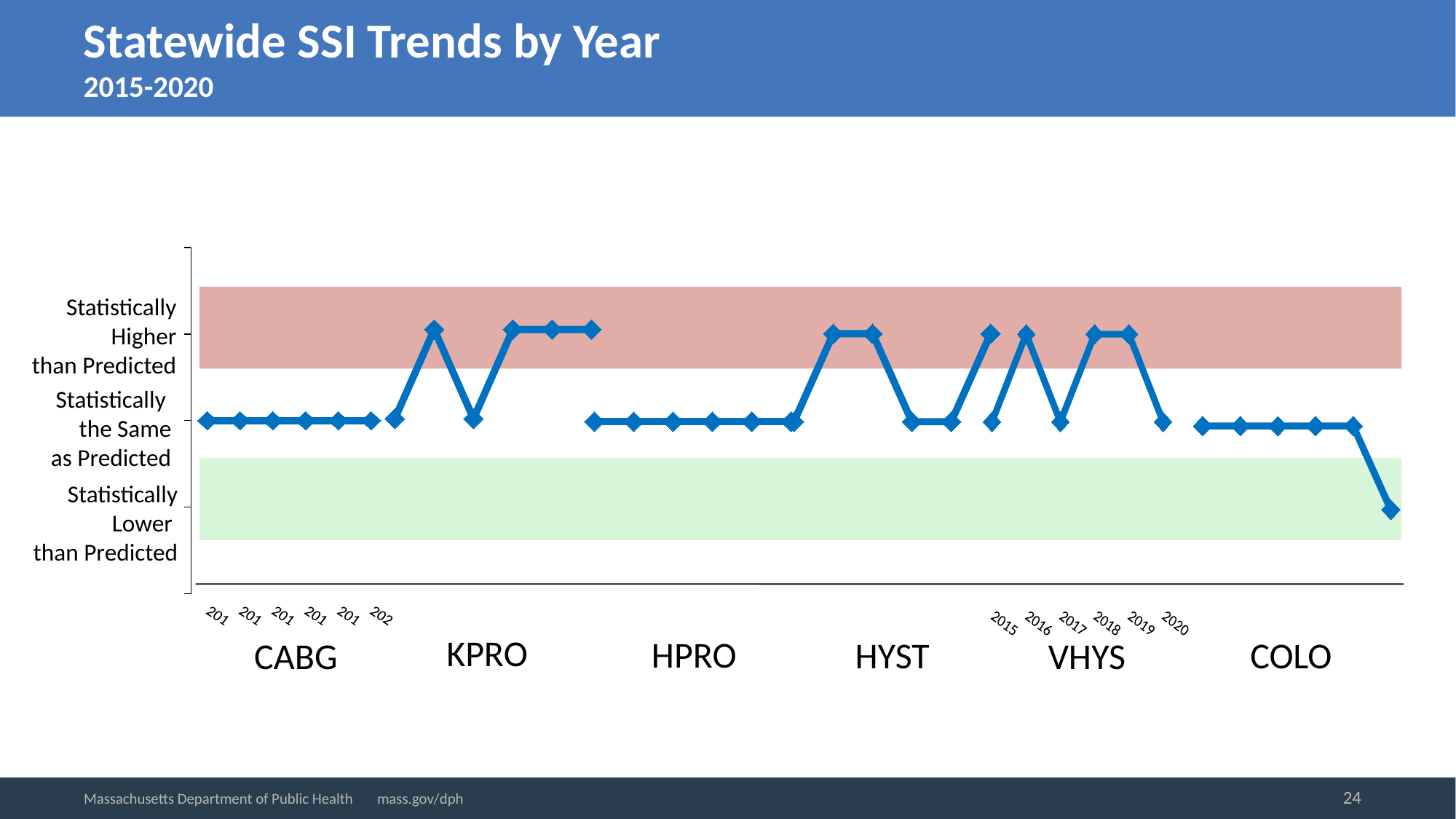
What colour is the shaded band for 'Statistically Higher than Predicted'? Red (pink) What kind of chart is shown on the slide? Line chart What is the SSI status for KPRO in 2016? Statistically Higher than Predicted What is the SSI status for HYST in 2017? Statistically Higher than Predicted How many procedure groups are shown along the x axis of the chart? 6 What is the SSI status for KPRO in 2017? Statistically the Same as Predicted How many years are plotted for each procedure group? 6 In which year does COLO fall into the 'Statistically Lower than Predicted' band? 2020 What is the SSI status for CABG across all years 2015-2020? Statistically the Same as Predicted What is the SSI status for VHYS in 2017? Statistically the Same as Predicted Which procedure group has a point in the 'Statistically Lower than Predicted' band? COLO What is the SSI status for HPRO across all years 2015-2020? Statistically the Same as Predicted